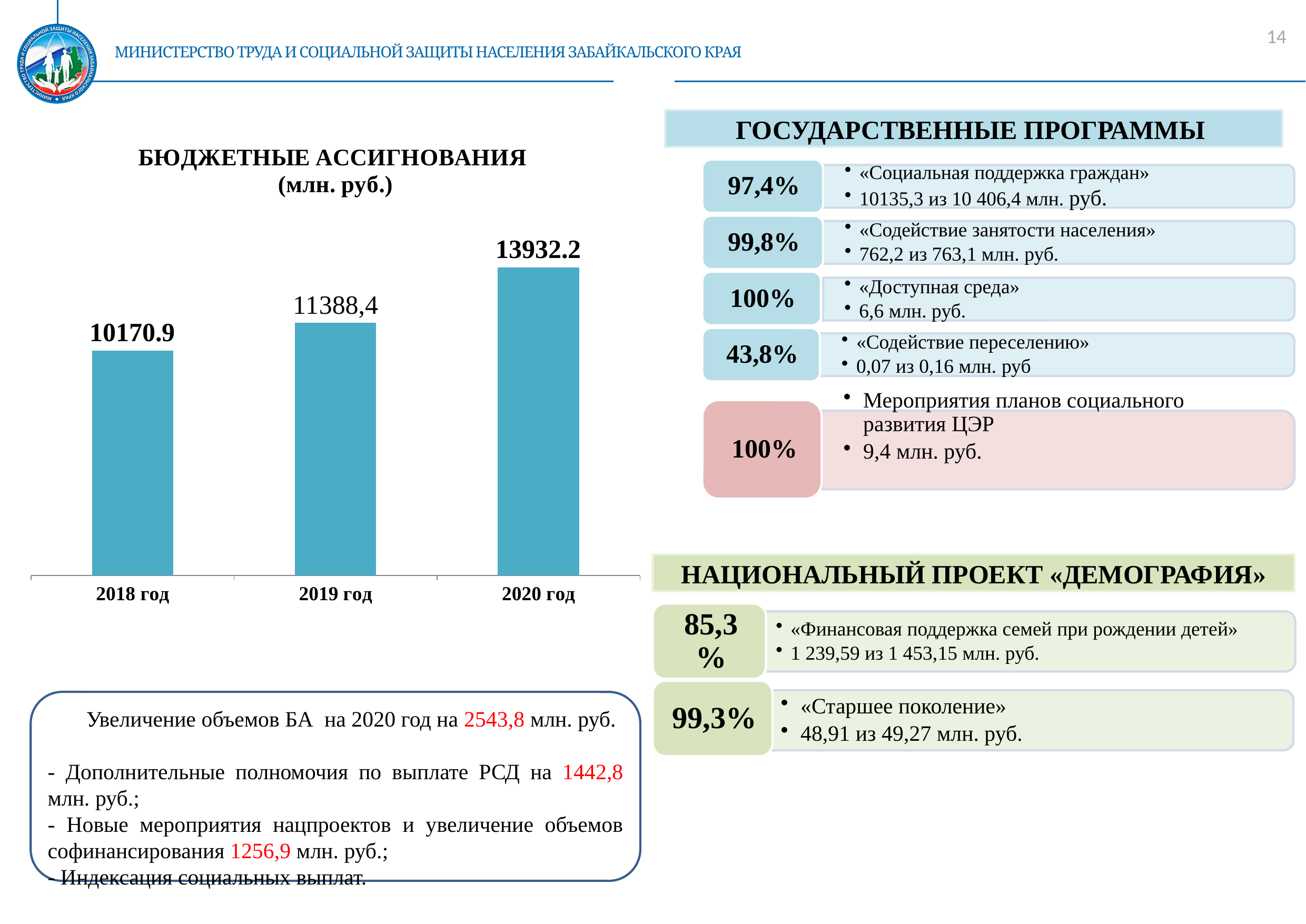
In the БЮДЖЕТНЫЕ АССИГНОВАНИЯ chart, which is larger: the value for 2019 год or 2020 год? 2020 год What type of chart is the БЮДЖЕТНЫЕ АССИГНОВАНИЯ chart? Bar chart What is the value for 2020 год in the БЮДЖЕТНЫЕ АССИГНОВАНИЯ chart? 13932.2 What unit is given in the title of the БЮДЖЕТНЫЕ АССИГНОВАНИЯ chart? млн. руб. Which year has the highest value in the БЮДЖЕТНЫЕ АССИГНОВАНИЯ chart? 2020 год Do the values in the БЮДЖЕТНЫЕ АССИГНОВАНИЯ chart rise or fall from 2018 год to 2020 год? Rise How many bars are shown in the БЮДЖЕТНЫЕ АССИГНОВАНИЯ chart? 3 What is the value for 2018 год in the БЮДЖЕТНЫЕ АССИГНОВАНИЯ chart? 10170.9 Which year has the lowest value in the БЮДЖЕТНЫЕ АССИГНОВАНИЯ chart? 2018 год In the БЮДЖЕТНЫЕ АССИГНОВАНИЯ chart, what is the difference between the 2020 год and 2018 год values? 3761.3 What is the value for 2019 год in the БЮДЖЕТНЫЕ АССИГНОВАНИЯ chart? 11388,4 In the БЮДЖЕТНЫЕ АССИГНОВАНИЯ chart, by how much does the 2020 год value exceed the 2019 год value? 2543,8